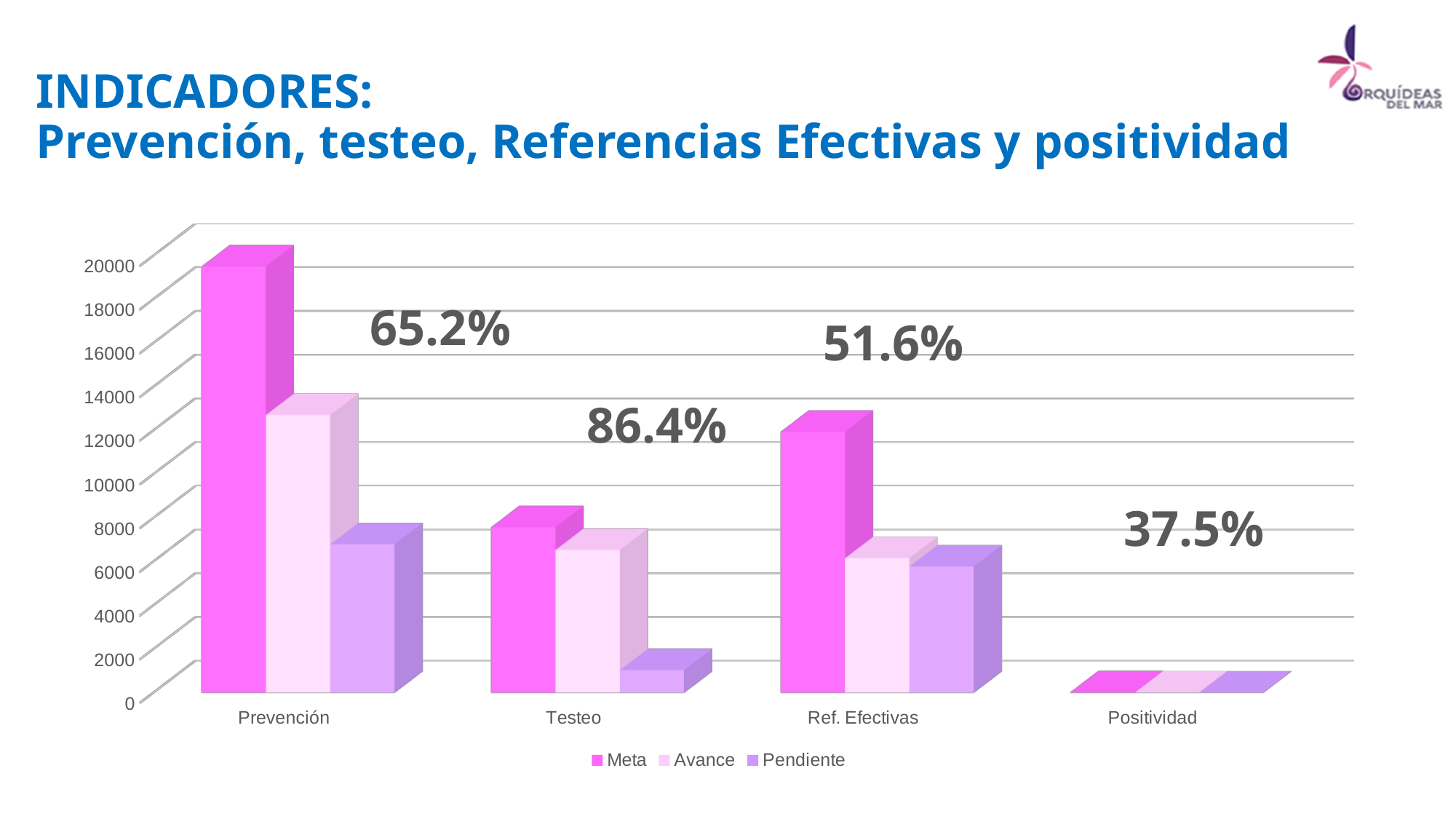
How many series does the chart legend list? 3 Which is larger, the Meta bar for Prevención or the Meta bar for Ref. Efectivas? Prevención Is the Pendiente value for Testeo greater or less than 2000? less How many categories are shown on the x axis of the chart? 4 Is the Meta value for Ref. Efectivas greater or less than 10000? greater Is the Meta value for Testeo greater or less than 10000? less Which category has the highest Meta bar? Prevención What percentage is printed above the Testeo bars? 86.4% Which category has the lowest Meta bar? Positividad What kind of chart is shown on the slide? bar chart What percentage is printed above the Positividad bars? 37.5%